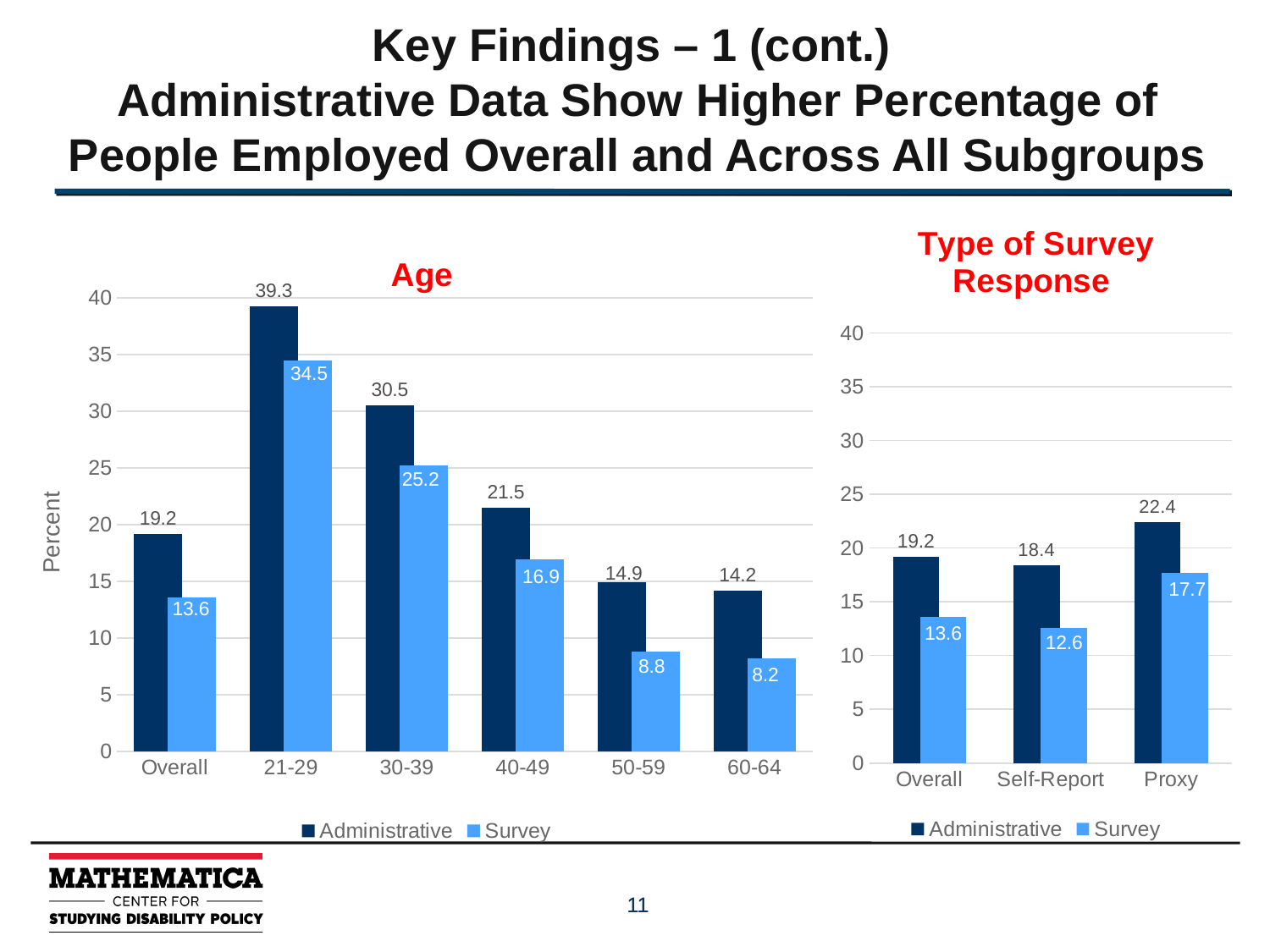
What type of chart is the Type of Survey Response chart? bar chart In the Age chart, what is the difference between the Administrative and Survey values for the 30-39 group? 5.3 In the Age chart, how many categories are shown on the x axis? 6 In the Age chart, what is the Survey value for the 50-59 age group? 8.8 In the Type of Survey Response chart, how many series does the legend list? 2 In the Age chart, which age group has the highest Survey value? 21-29 In the Age chart, do the Administrative values rise or fall from 21-29 to 60-64? fall In the Type of Survey Response chart, what is the Survey value for Self-Report? 12.6 In the Type of Survey Response chart, what is the Administrative value for Proxy? 22.4 In the Age chart, which category has the lowest Administrative value? 60-64 In the Type of Survey Response chart, which is larger: the Survey value for Proxy or the Survey value for Overall? Proxy In the Age chart, what is the Administrative value for the 21-29 age group? 39.3